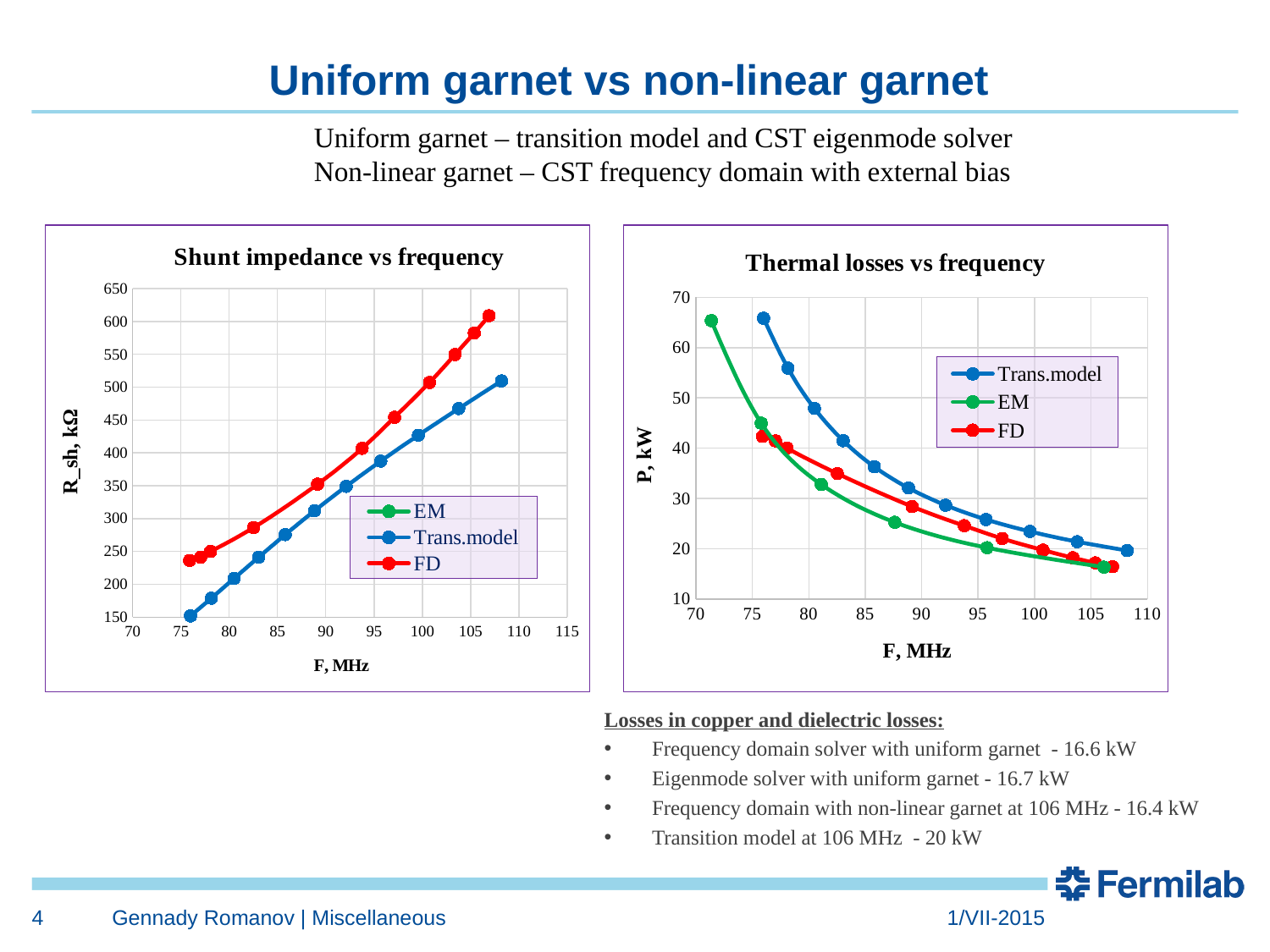
In the 'Thermal losses vs frequency' chart, is the Trans.model value at its lowest frequency point (about 76 MHz) greater or less than 60? greater What kind of chart is the 'Shunt impedance vs frequency' chart? line chart In the 'Shunt impedance vs frequency' chart, do the FD values rise or fall as frequency increases? rise In the 'Shunt impedance vs frequency' chart, is the Trans.model value at its lowest frequency point (about 76 MHz) greater or less than 200? less How many series does the legend of the 'Shunt impedance vs frequency' chart list? 3 What kind of chart is the 'Thermal losses vs frequency' chart? line chart In the 'Thermal losses vs frequency' chart, is the FD value at its lowest frequency point (about 76 MHz) greater or less than 50? less In the 'Thermal losses vs frequency' chart, at about 76 MHz, which series has the larger value: Trans.model or FD? Trans.model What is the y-axis label of the 'Thermal losses vs frequency' chart? P, kW How many series does the legend of the 'Thermal losses vs frequency' chart list? 3 In the 'Thermal losses vs frequency' chart, do the Trans.model values rise or fall as frequency increases? fall